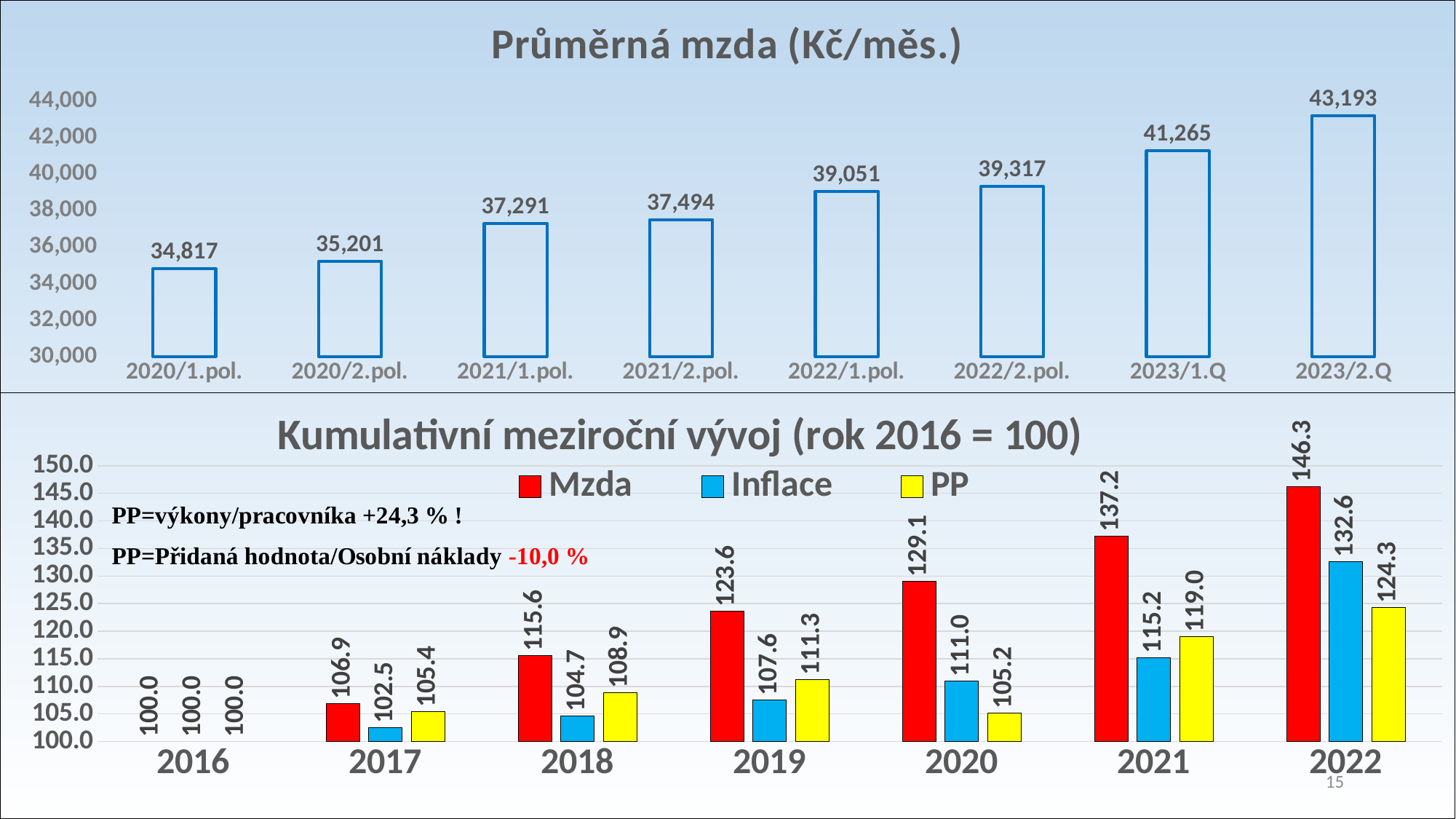
In the 'Průměrná mzda (Kč/měs.)' chart, do the values rise or fall from 2020/1.pol. to 2023/2.Q? rise What kind of chart is the 'Kumulativní meziroční vývoj (rok 2016 = 100)' chart? bar chart In the 'Kumulativní meziroční vývoj (rok 2016 = 100)' chart, what is the Inflace value for 2021? 115.2 In the 'Průměrná mzda (Kč/měs.)' chart, which period has the lowest value? 2020/1.pol. In the 'Kumulativní meziroční vývoj (rok 2016 = 100)' chart, which is larger in 2020, Inflace or PP? Inflace In the 'Průměrná mzda (Kč/měs.)' chart, what is the value for 2022/1.pol.? 39,051 In the 'Kumulativní meziroční vývoj (rok 2016 = 100)' chart, how many series does the legend list? 3 In the 'Průměrná mzda (Kč/měs.)' chart, what is the difference between the values for 2023/2.Q and 2023/1.Q? 1,928 In the 'Kumulativní meziroční vývoj (rok 2016 = 100)' chart, what is the difference between the Mzda and Inflace values for 2022? 13.7 In the 'Průměrná mzda (Kč/měs.)' chart, which period has the highest value? 2023/2.Q In the 'Kumulativní meziroční vývoj (rok 2016 = 100)' chart, what is the PP value for 2019? 111.3 In the 'Průměrná mzda (Kč/měs.)' chart, how many periods are shown on the x axis? 8